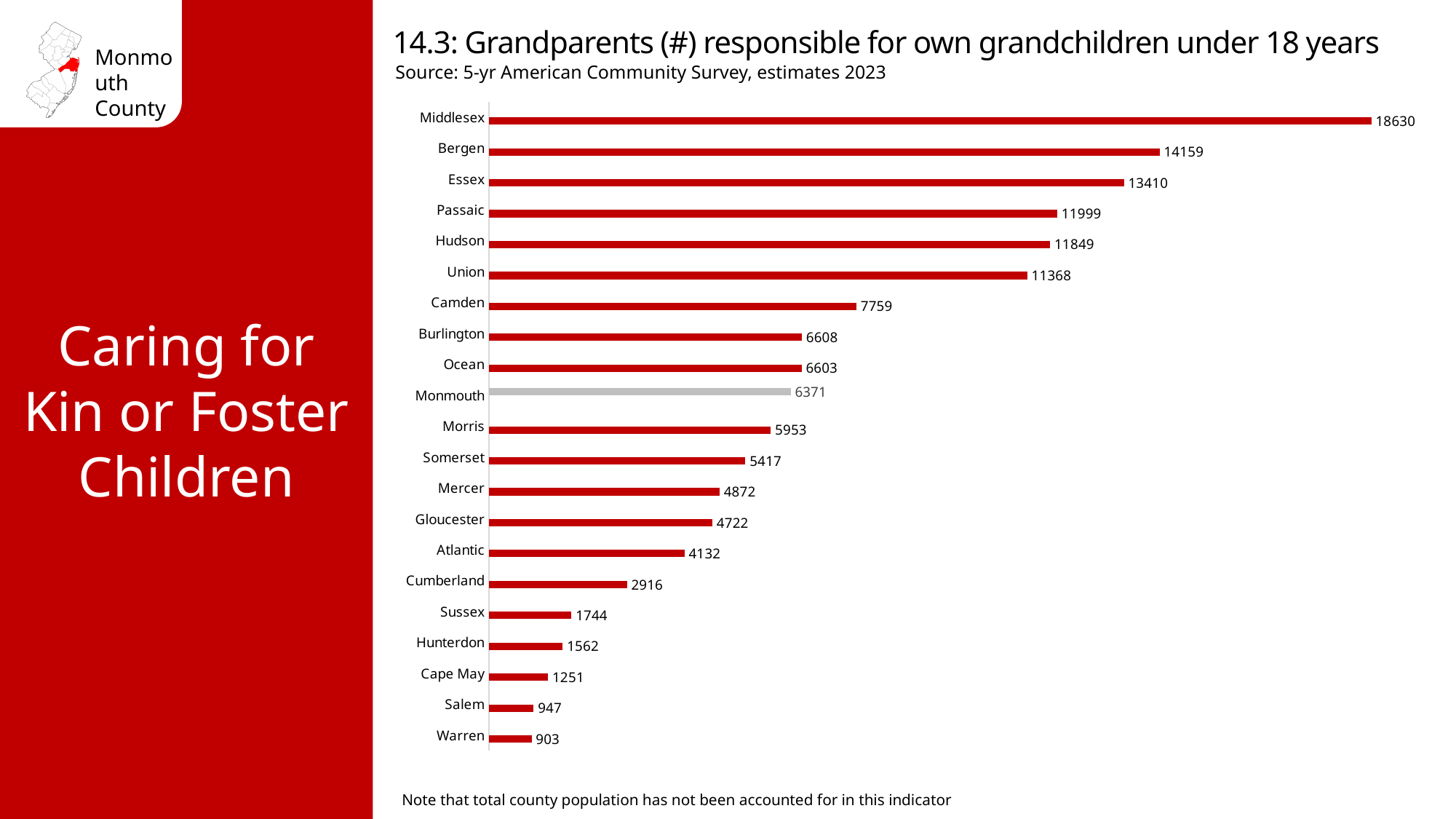
Which county has the highest value? Middlesex Which county's bar is shown in grey rather than red? Monmouth Which county has the lowest value? Warren Which is larger, the value for Camden or the value for Burlington? Camden What is the value for Cumberland? 2916 How many counties are shown in the chart? 21 What is the difference between the values for Bergen and Essex? 749 What is the difference between the values for Monmouth and Morris? 418 Which is larger, the value for Hunterdon or the value for Sussex? Sussex What is the value for Monmouth? 6371 What kind of chart is shown on the slide? Bar chart What is the value for Middlesex? 18630